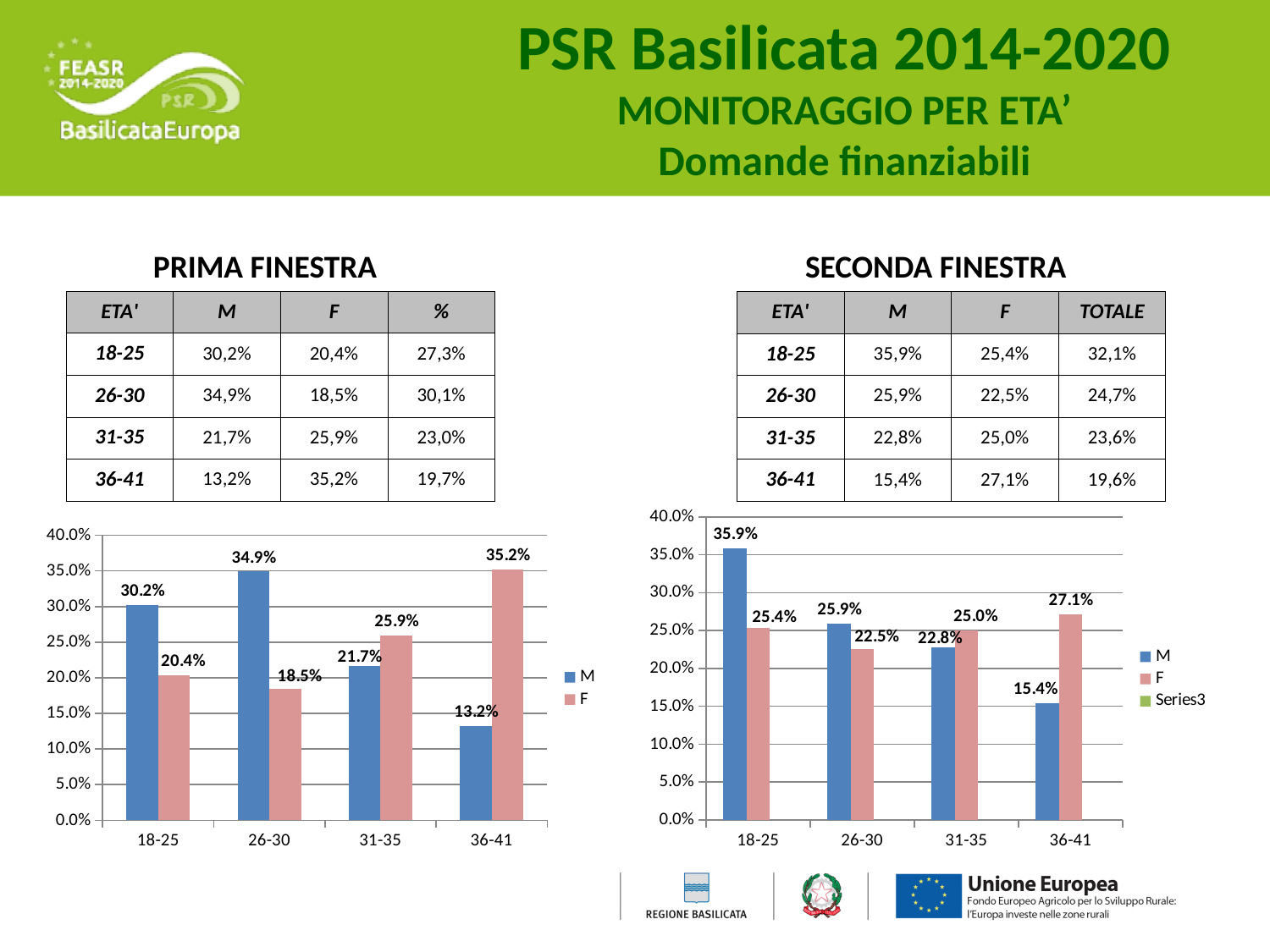
In the PRIMA FINESTRA chart, what is the difference between the M and F values for the 18-25 age group? 9.8% In the SECONDA FINESTRA chart, which age group has the highest F value? 36-41 In the PRIMA FINESTRA chart, which is larger for the 31-35 age group, M or F? F In the PRIMA FINESTRA chart, which age group has the lowest M value? 36-41 In the SECONDA FINESTRA chart, what is the value of the M series for the 18-25 age group? 35.9% In the PRIMA FINESTRA chart, how many series does the legend list? 2 In the SECONDA FINESTRA chart, how many age groups are shown on the x axis? 4 In the SECONDA FINESTRA chart, how many series does the legend list? 3 In the PRIMA FINESTRA chart, what is the value of the F series for the 36-41 age group? 35.2% In the SECONDA FINESTRA chart, what is the difference between the F and M values for the 36-41 age group? 11.7% In the PRIMA FINESTRA chart, what is the value of the M series for the 26-30 age group? 34.9% What type of chart is the SECONDA FINESTRA chart? Bar chart